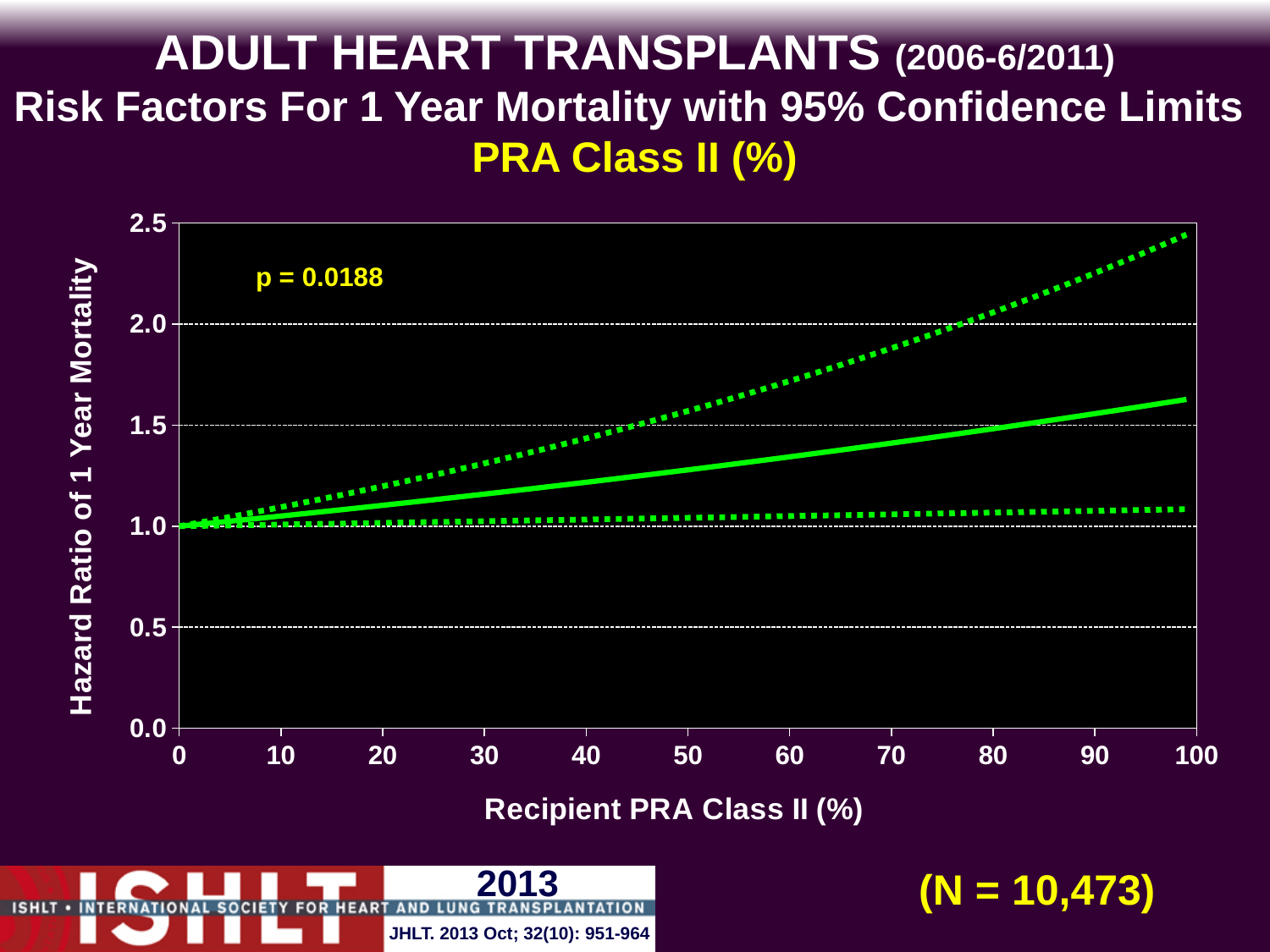
What is the maximum value shown on the y-axis? 2.5 Is the hazard ratio on the solid line at a Recipient PRA Class II of 100% greater or less than 1.5? greater What is the label of the y-axis? Hazard Ratio of 1 Year Mortality What kind of chart is shown on the slide? line chart Is the lower dotted confidence limit at a Recipient PRA Class II of 100% greater or less than 1.5? less Is the upper dotted confidence limit at a Recipient PRA Class II of 100% greater or less than 2.0? greater What is the p-value shown on the chart? p = 0.0188 What is the sample size (N) shown on the slide? N = 10,473 How many lines are plotted on the chart? 3 Does the solid hazard ratio line rise or fall as Recipient PRA Class II (%) increases from 0 to 100? rise